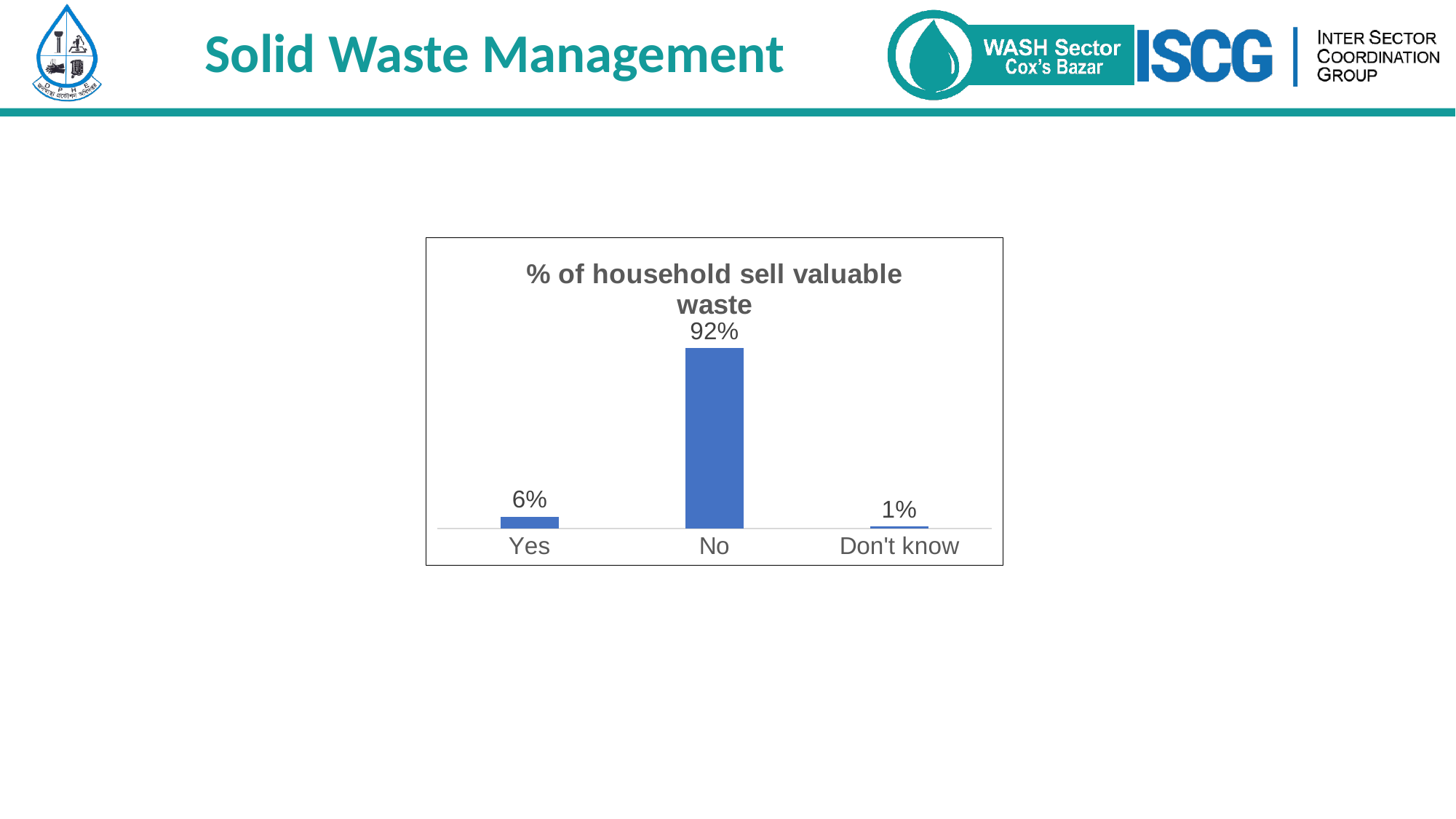
What percentage of households answered 'No' to selling valuable waste? 92% What percentage of households answered 'Yes' to selling valuable waste? 6% What is the title of the chart? % of household sell valuable waste What kind of chart is shown on the slide? Bar chart Which category has the highest value? No How many categories are shown on the x axis? 3 What is the value shown for 'Don't know'? 1% What colour are the bars in the chart? Blue Which is larger, the value for 'Yes' or the value for 'Don't know'? Yes What is the difference between the 'Yes' and 'Don't know' values? 5% What is the difference between the 'No' and 'Yes' values? 86% Which category has the lowest value? Don't know